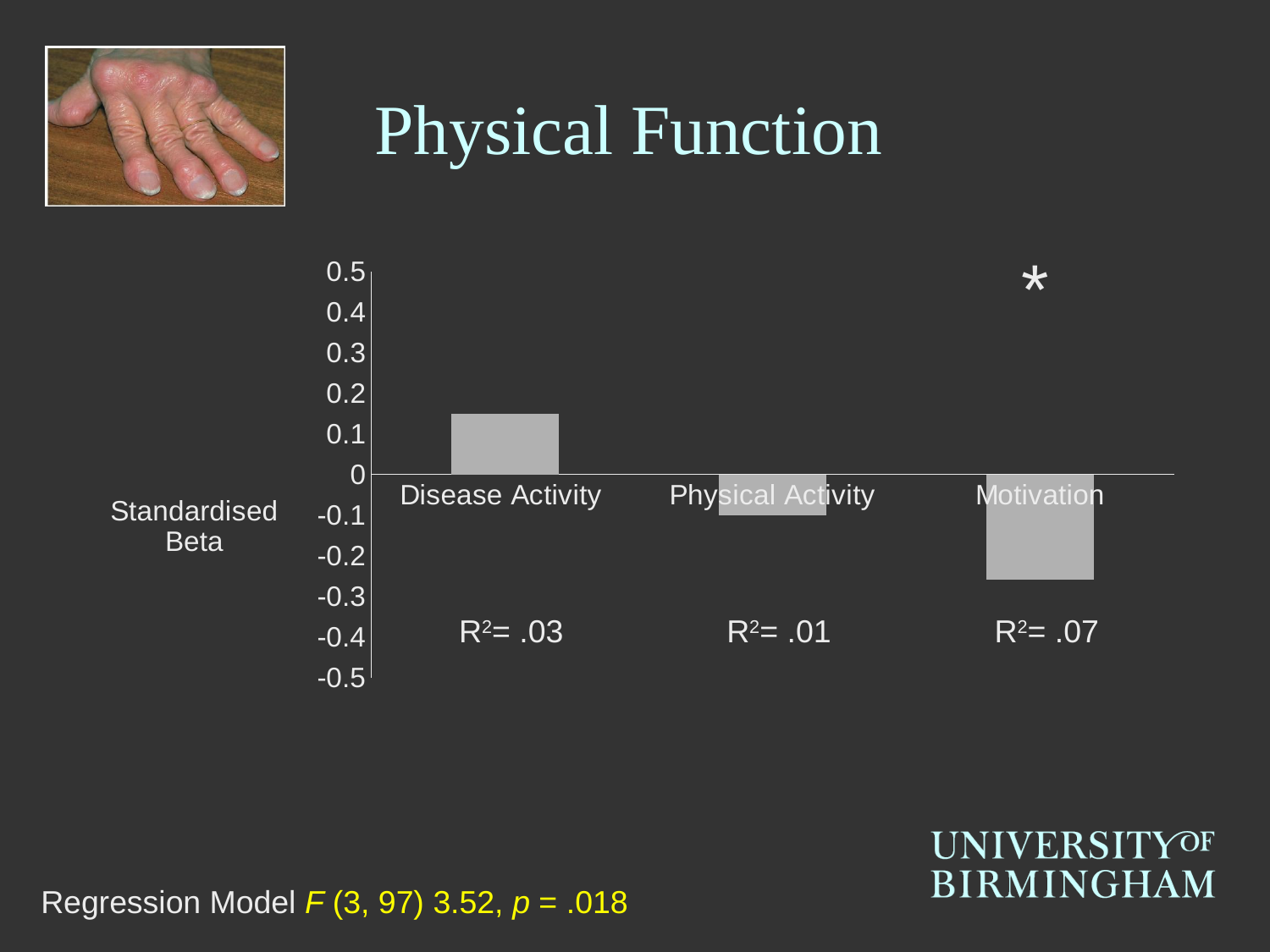
Which is larger, the value for Disease Activity or the value for Motivation? Disease Activity Is the value for Motivation greater or less than -0.2? less How many categories are plotted on the chart? 3 What R² value is printed under the Motivation bar? .07 Which category has the highest standardised beta? Disease Activity How many of the bars have negative values? 2 What kind of chart is shown on the slide? bar chart What is the title of the chart? Physical Function Is the value for Disease Activity greater or less than 0.1? greater Which category has the lowest standardised beta? Motivation Is the value for Physical Activity greater or less than 0? less Which category is marked with an asterisk on the chart? Motivation